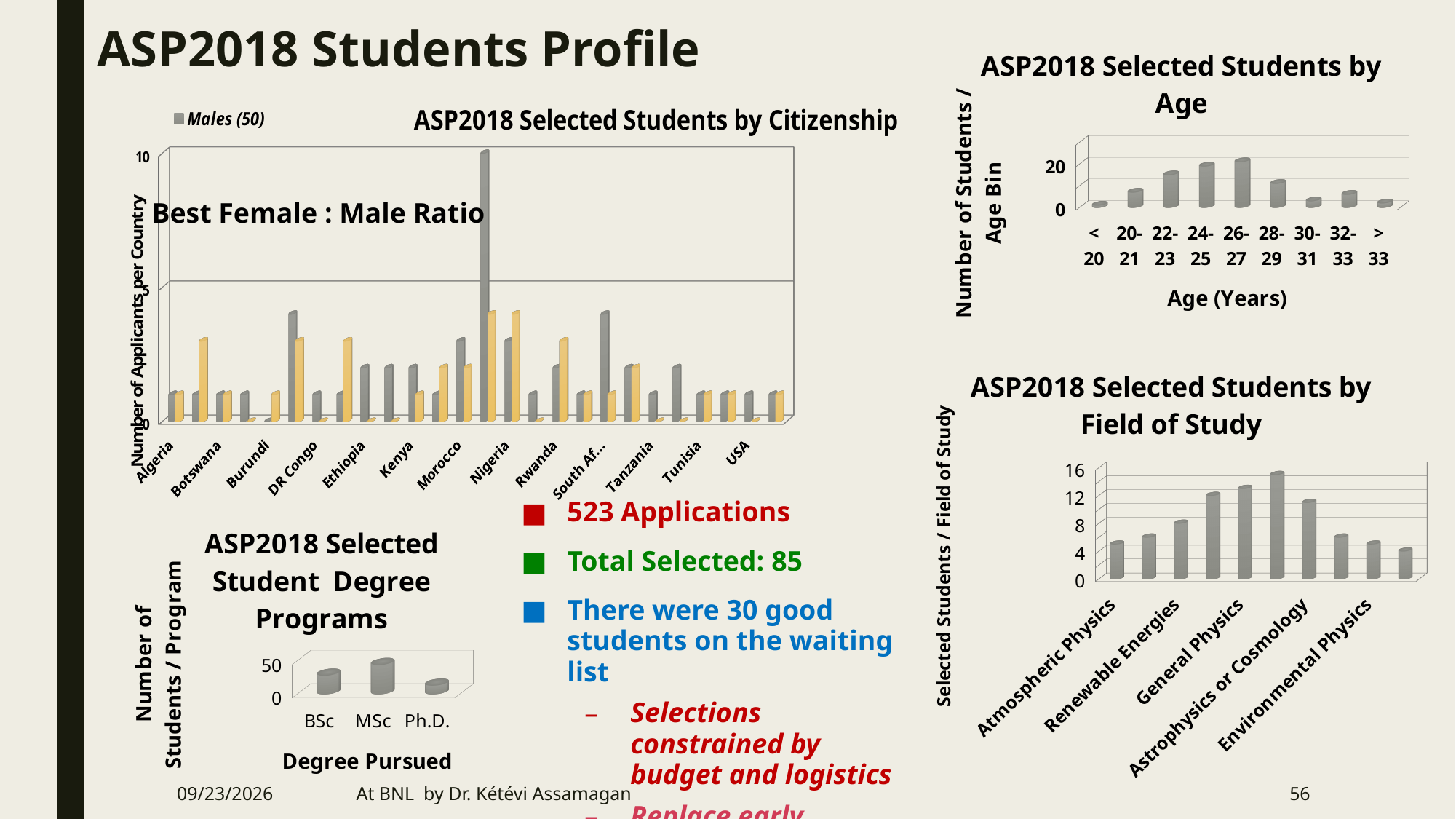
How many age bins are shown in the 'ASP2018 Selected Students by Age' chart? 9 In the 'ASP2018 Selected Students by Age' chart, which age bin has the highest number of students? 26-27 How many fields of study are shown in the 'ASP2018 Selected Students by Field of Study' chart? 10 In the 'ASP2018 Selected Student Degree Programs' chart, which degree has the highest number of students? MSc What kind of chart is the 'ASP2018 Selected Students by Citizenship' chart? bar chart In the 'ASP2018 Selected Students by Field of Study' chart, is the value for General Physics greater or less than 8? greater In the 'ASP2018 Selected Student Degree Programs' chart, which degree has the lowest number of students? Ph.D.